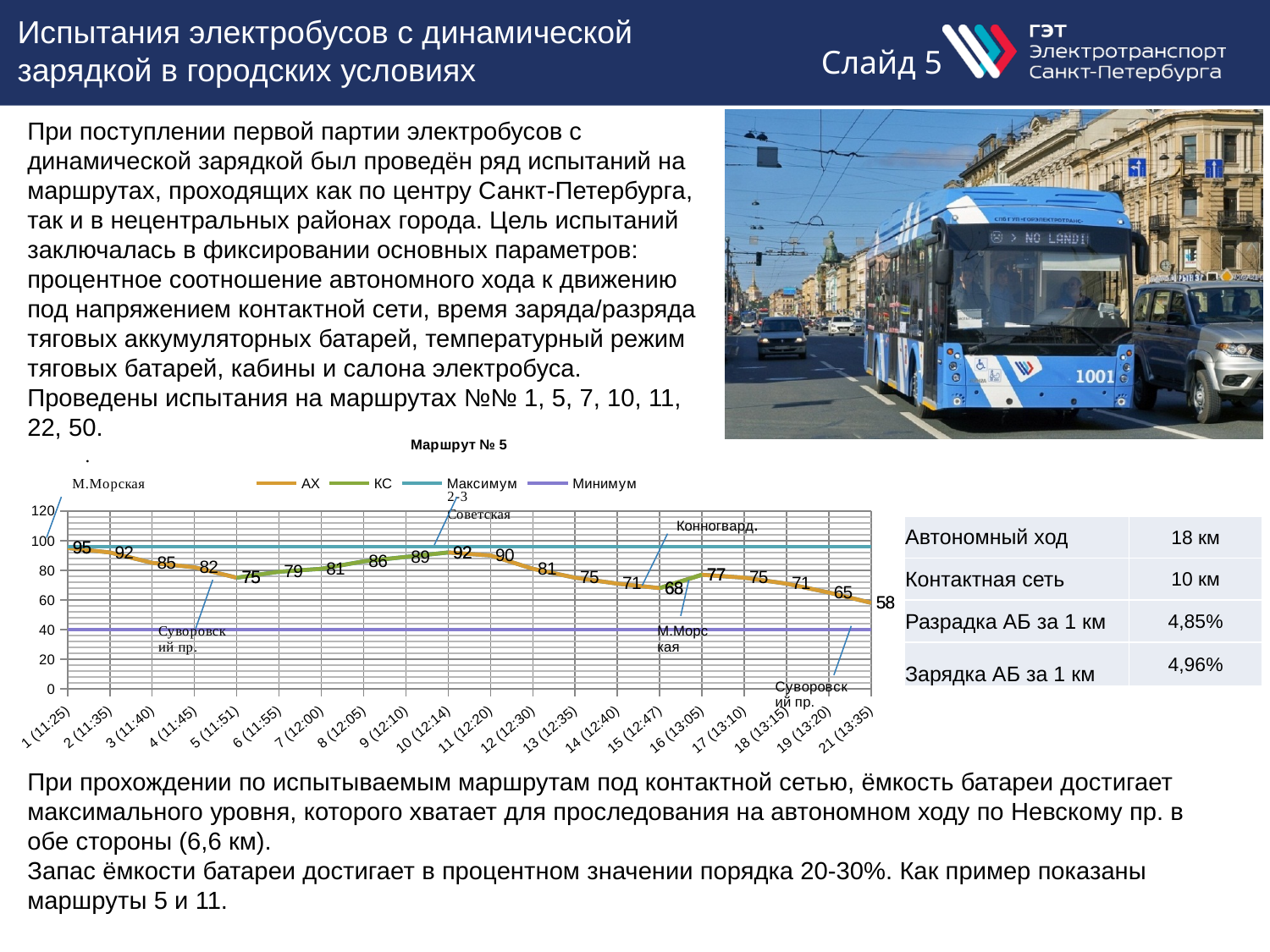
What are the legend entries of the chart? АХ, КС, Максимум, Минимум What is the labelled value at point 1 (11:25)? 95 How many points are labelled along the x axis of the chart? 20 What is the title of the chart? Маршрут № 5 How many series does the chart legend list? 4 What kind of chart is shown on the slide? line chart Is the value of the Минимум line greater or less than 60? less Which has the larger labelled value: point 10 (12:14) or point 11 (12:20)? 10 (12:14) What is the difference between the labelled values at 1 (11:25) and 21 (13:35)? 37 What is the labelled value at point 21 (13:35)? 58 At which x-axis point is the labelled value the lowest? 21 (13:35) At which x-axis point is the labelled value the highest? 1 (11:25)